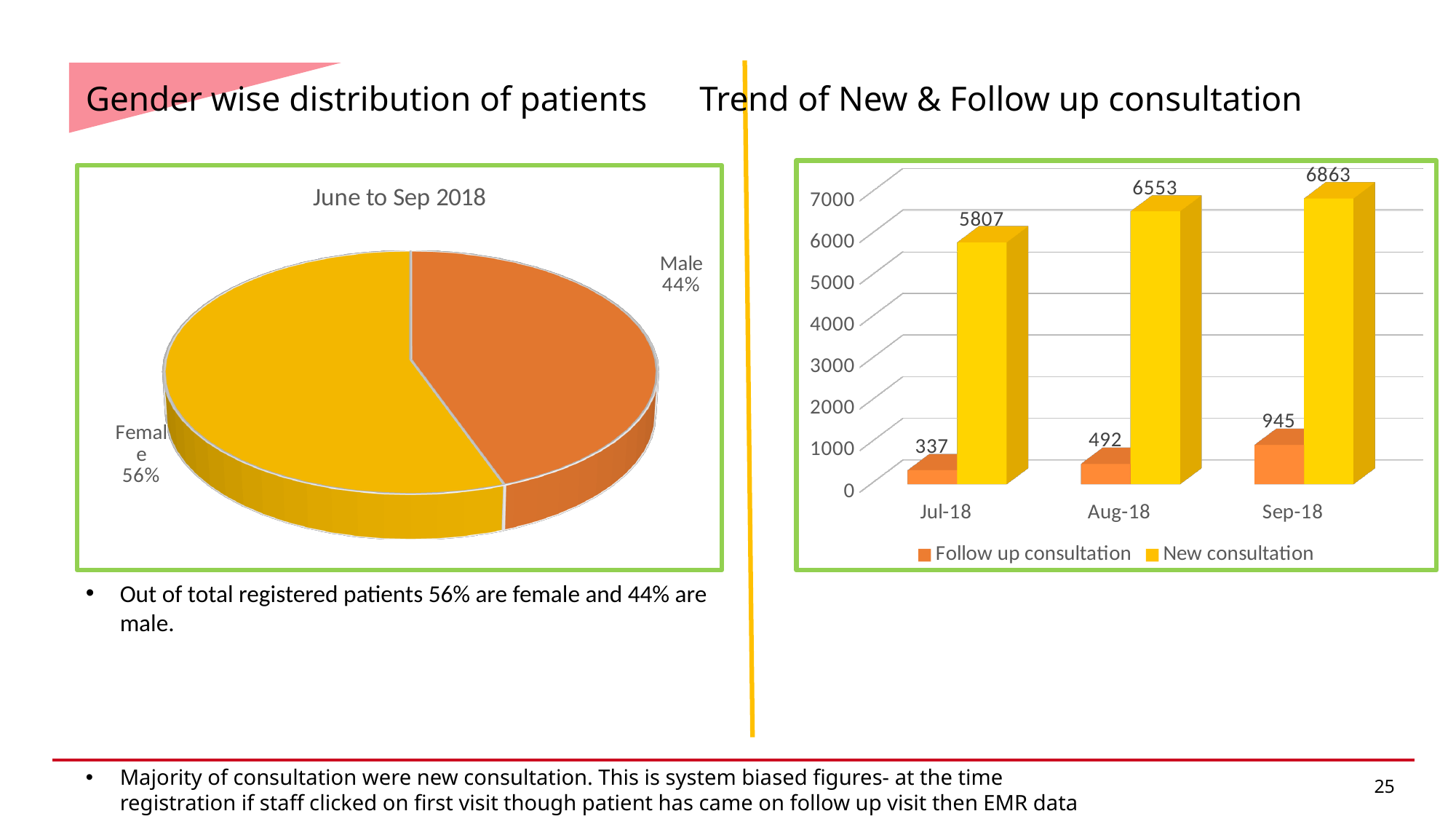
In the chart on the right, which month has the lowest Follow up consultation value? Jul-18 In the chart on the right, what is the difference between New consultation in Sep-18 and Jul-18? 1056 How many series does the legend of the chart on the right list? 2 In the pie chart titled 'June to Sep 2018', what share of patients are female? 56% In the chart on the right, what is the value for New consultation in Aug-18? 6553 In the pie chart titled 'June to Sep 2018', which gender has the larger share? Female In the chart on the right, which month has the highest New consultation value? Sep-18 In the pie chart titled 'June to Sep 2018', what share of patients are male? 44% What kind of chart is the chart on the right of the slide? Bar chart What kind of chart is the chart on the left of the slide? Pie chart In the chart on the right, what is the value for Follow up consultation in Sep-18? 945 In the chart on the right, do the New consultation values rise or fall from Jul-18 to Sep-18? Rise